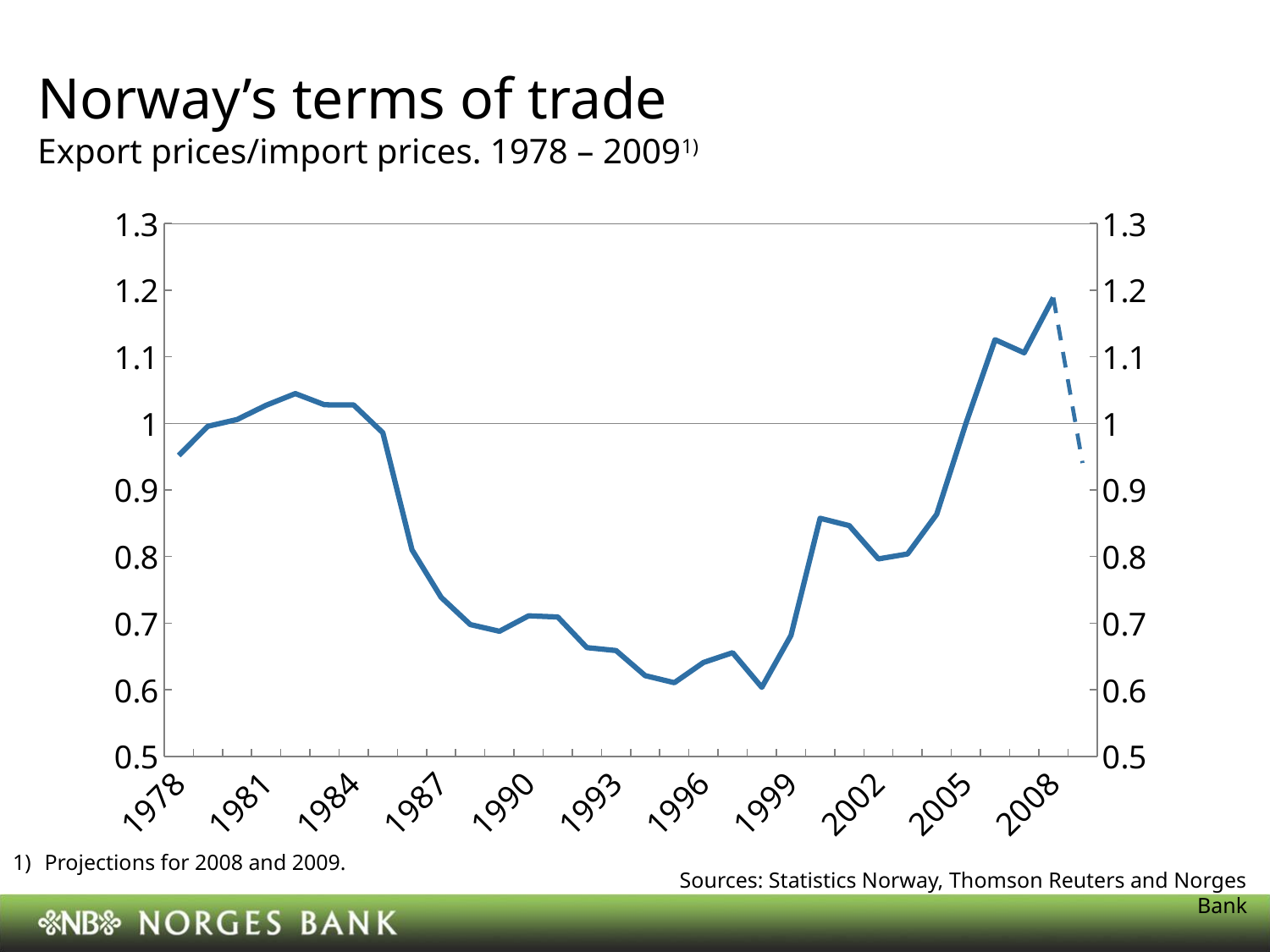
Is the projected value for 2009 greater or less than 1? less Is the value for 1978 greater or less than 1? less According to the footnote, which years are projections? 2008 and 2009 Is the value for 1987 greater or less than 0.8? less What is the title of the chart on the slide? Norway's terms of trade Does the series rise or fall between 2003 and 2008? rise Does the series rise or fall between 1985 and 1987? fall What kind of chart is shown on the slide? line chart How many year labels are shown on the x axis? 11 In which year does Norway's terms of trade reach its highest value on the chart? 2008